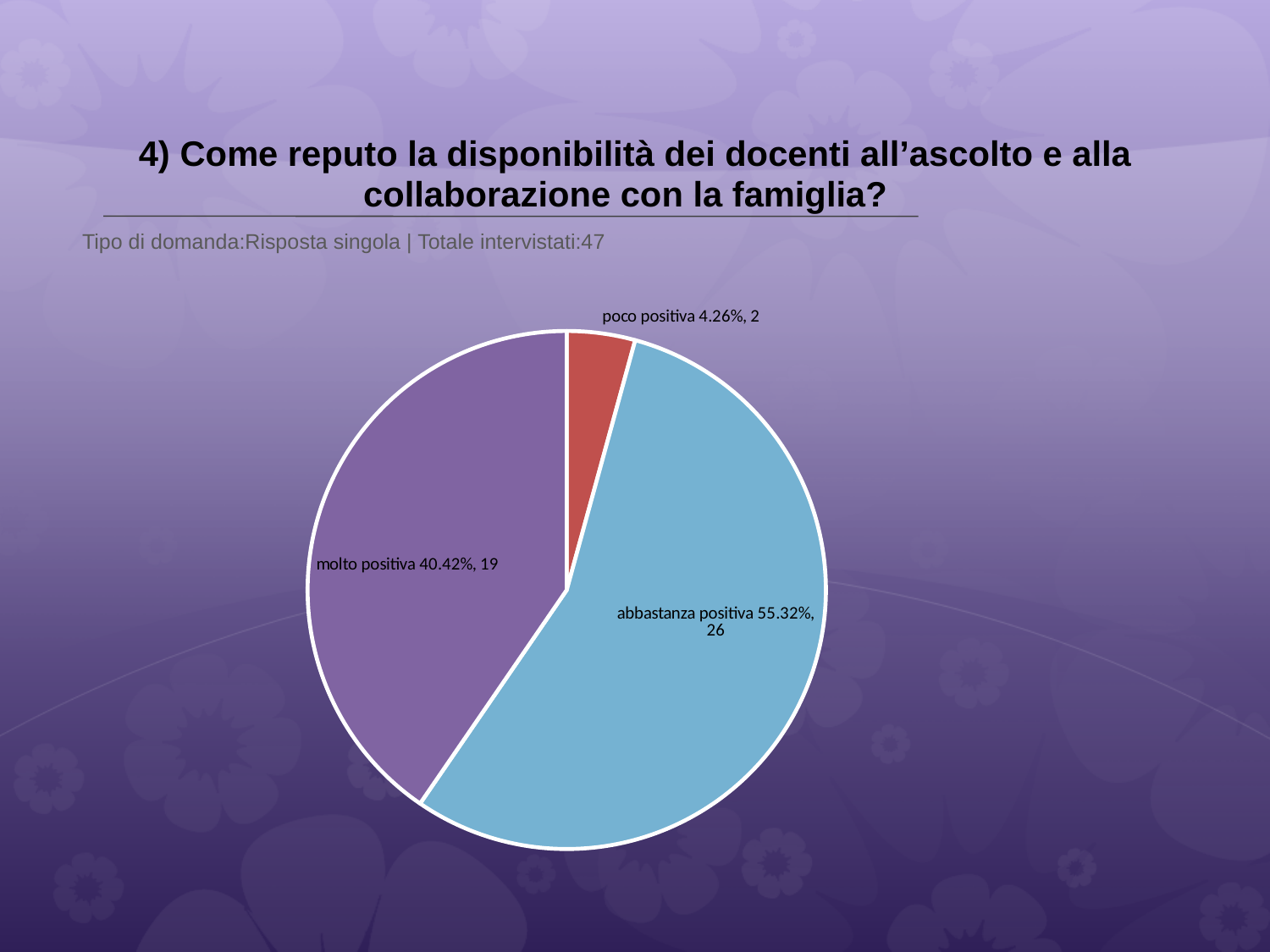
Which category has the smallest slice? poco positiva What colour is the 'poco positiva' slice? red What is the total number of respondents shown on the slide? 47 What percentage share does the 'abbastanza positiva' slice have? 55.32% How many slices does the pie chart have? 3 Which has more respondents, 'molto positiva' or 'poco positiva'? molto positiva How many respondents answered 'molto positiva'? 19 What kind of chart is shown on the slide? pie chart Which category has the largest slice? abbastanza positiva What is the difference in respondent count between 'abbastanza positiva' and 'molto positiva'? 7 How many respondents answered 'poco positiva'? 2 What percentage share does the 'molto positiva' slice have? 40.42%